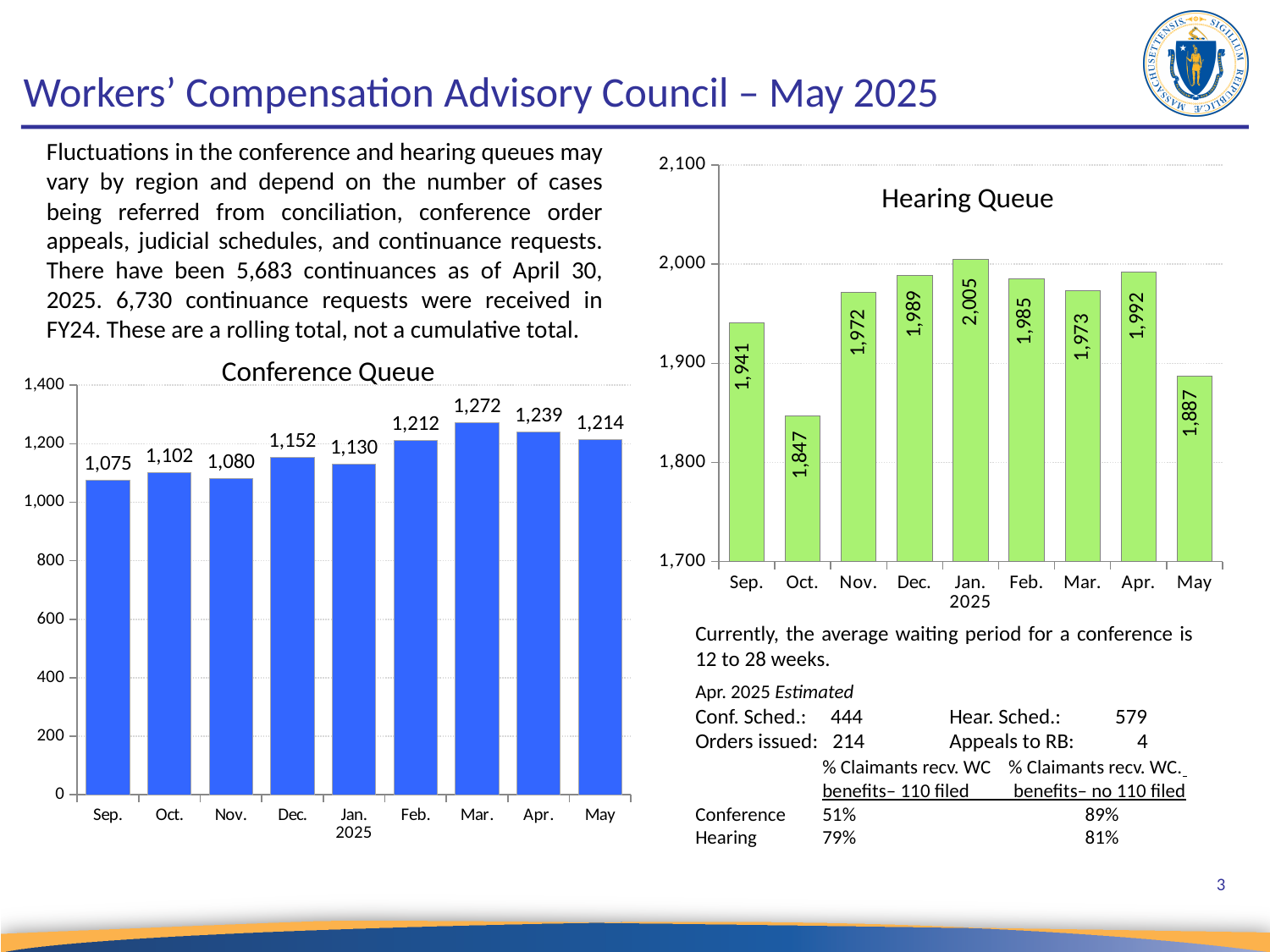
What kind of chart is the Hearing Queue chart? bar chart In the Conference Queue chart, what is the value for Mar.? 1,272 In the Hearing Queue chart, which month has the lowest value? Oct. What colour are the bars in the Conference Queue chart? blue In the Hearing Queue chart, what is the difference between the values for Jan. 2025 and May? 118 In the Hearing Queue chart, what is the value for Oct.? 1,847 In the Conference Queue chart, what is the difference between the values for Mar. and Sep.? 197 In the Conference Queue chart, which is larger, the value for Dec. or the value for Jan. 2025? Dec. In the Hearing Queue chart, which month has the highest value? Jan. 2025 In the Conference Queue chart, which month has the highest value? Mar. In the Hearing Queue chart, is the value for May greater or less than 1,900? less How many months are plotted in the Conference Queue chart? 9